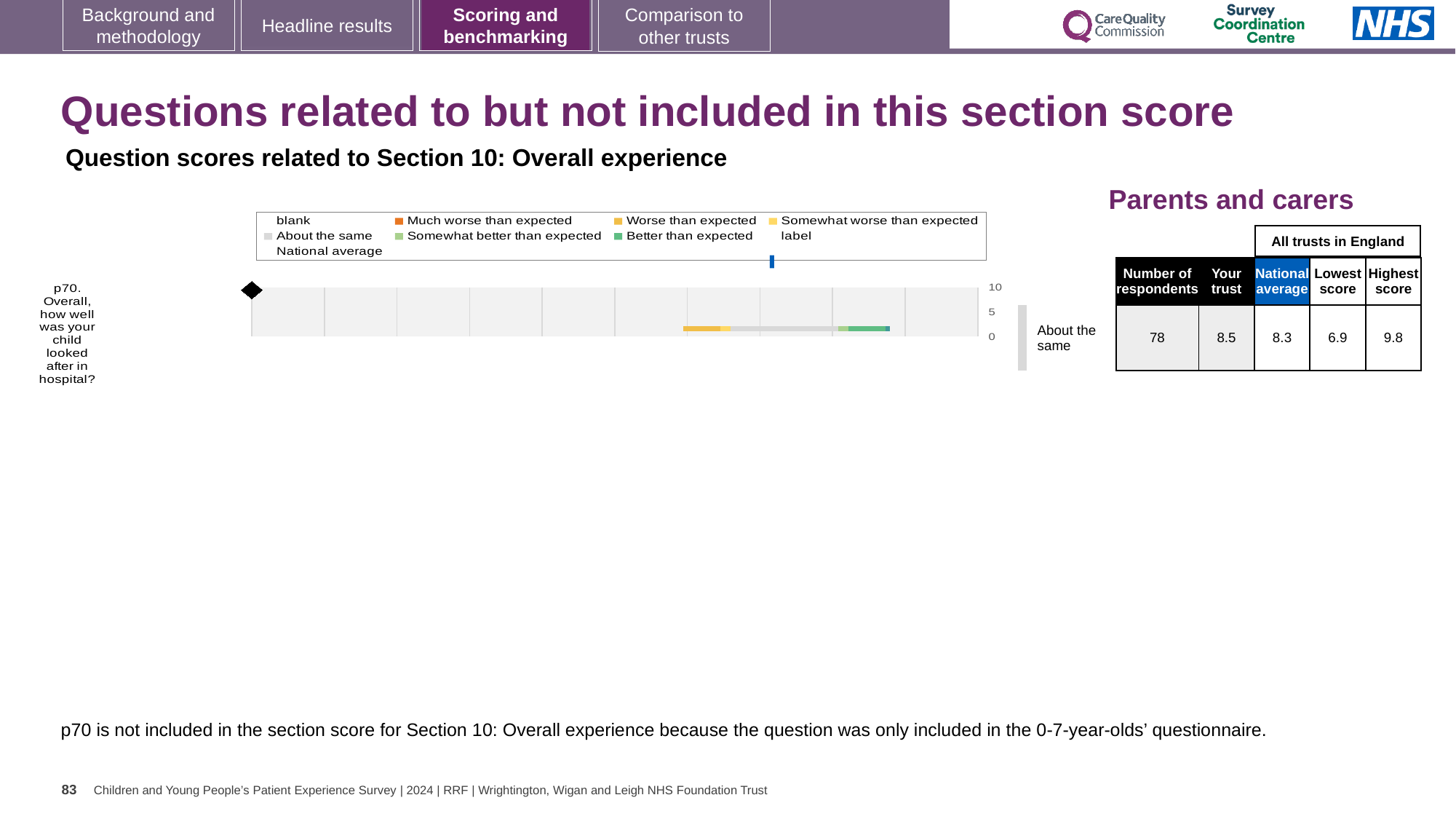
What comparison label is shown to the right of the p70 bar? About the same How many respondents answered p70 in the Parents and carers table? 78 What kind of chart is used to show the p70 question score? bar chart What is the 'Your trust' score for p70 in the Parents and carers table? 8.5 What is the difference between the 'Your trust' score and the national average for p70? 0.2 For p70, which is higher: the 'Your trust' score or the national average? Your trust What is the highest score among all trusts in England for p70? 9.8 What is the national average score for p70 in the Parents and carers table? 8.3 What is the lowest score among all trusts in England for p70? 6.9 Which question is plotted in the chart? p70. Overall, how well was your child looked after in hospital? What is the difference between the highest score and the lowest score for p70? 2.9 How many questions are plotted in the chart? 1